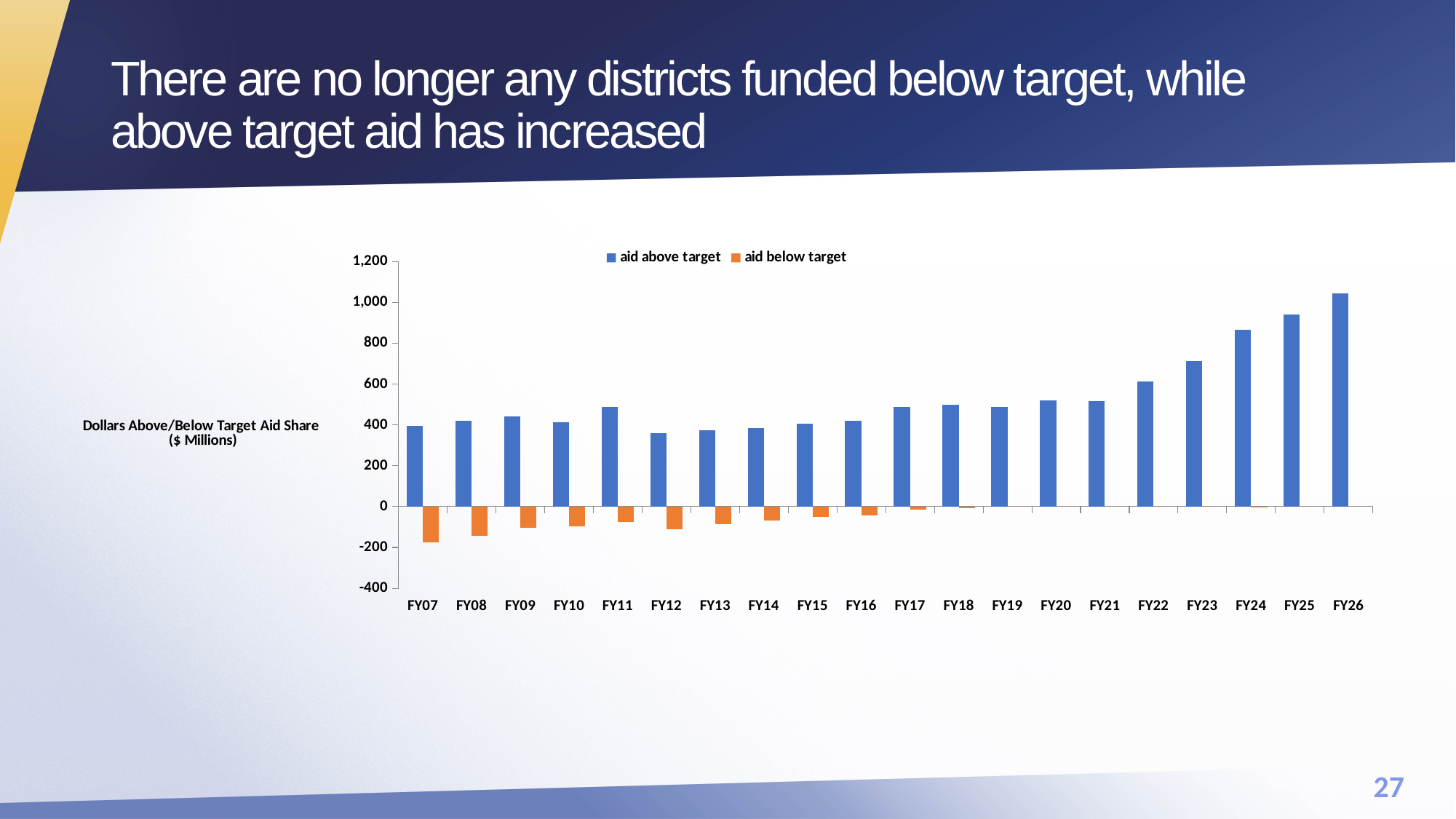
Which fiscal year has the lowest (most negative) value for aid below target? FY07 Does aid above target generally rise or fall from FY07 to FY26? rise Is the value for aid below target in FY07 greater or less than -200? greater Is the value for aid above target in FY23 greater or less than 600? greater Is the value for aid above target in FY25 greater or less than 1,000? less How many series does the legend list? 2 What colour represents aid below target in the chart? orange What kind of chart is shown on the slide? bar chart Which is larger, aid above target in FY17 or in FY12? FY17 Which fiscal year has the highest value for aid above target? FY26 How many fiscal years are shown on the x axis? 20